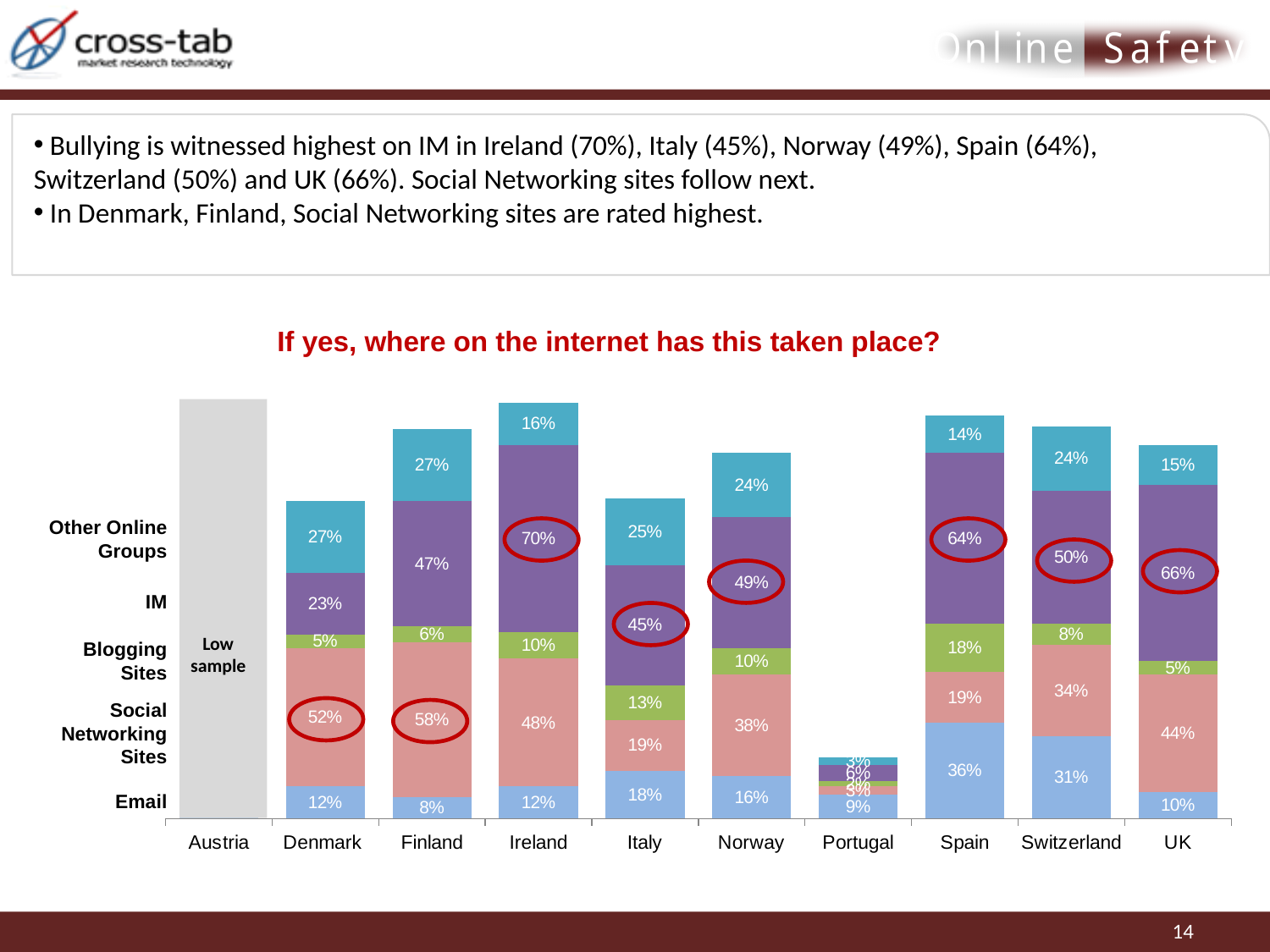
Which is larger, the Social Networking Sites value for Denmark or for the UK? Denmark How many countries are shown on the x axis? 10 What is the Email value for Spain? 36% What is the Social Networking Sites value for Finland? 58% Which country has the highest IM value? Ireland How many series (internet locations) are stacked in each bar? 5 Which country has the lowest Email value? Finland What percentage is shown for IM in Ireland? 70% What kind of chart is shown? Stacked bar chart What is the difference between the IM values for Spain and Italy? 19 percentage points What is the Other Online Groups value for Switzerland? 24% Which country is marked as 'Low sample' instead of showing data? Austria